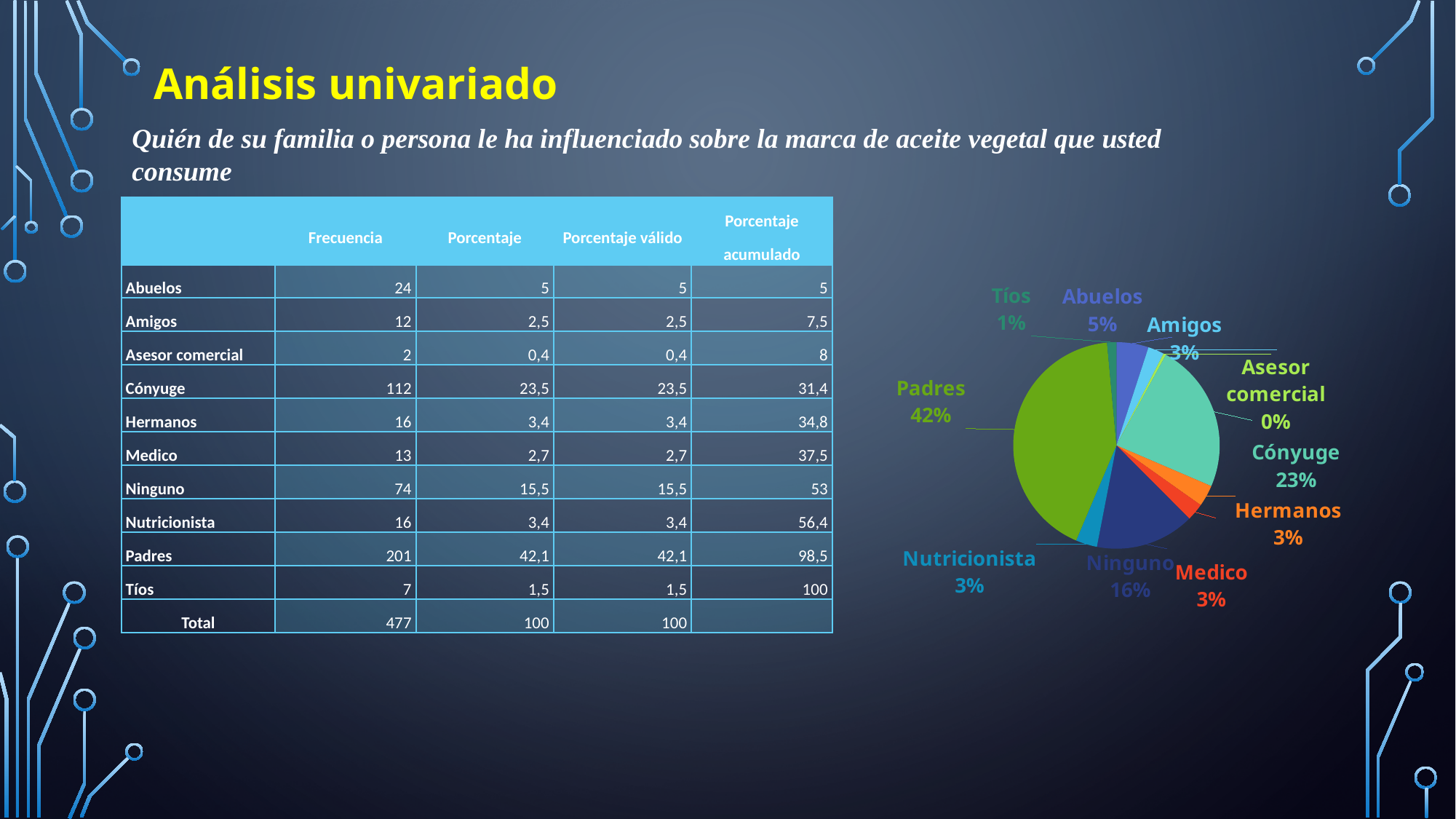
In the pie chart, what share is labelled for Ninguno? 16% In the pie chart, which slice is larger: Cónyuge or Ninguno? Cónyuge In the pie chart, what share is labelled for Asesor comercial? 0% In the pie chart, what share is labelled for Tíos? 1% In the pie chart, what share is labelled for Cónyuge? 23% In the pie chart, what is the difference between the shares of Padres and Cónyuge? 19% Which category has the smallest labelled share in the pie chart? Asesor comercial Which category has the largest slice in the pie chart? Padres In the pie chart, what share is labelled for Padres? 42% How many categories are labelled in the pie chart? 10 In the pie chart, what share is labelled for Abuelos? 5% What kind of chart is shown on the slide? pie chart